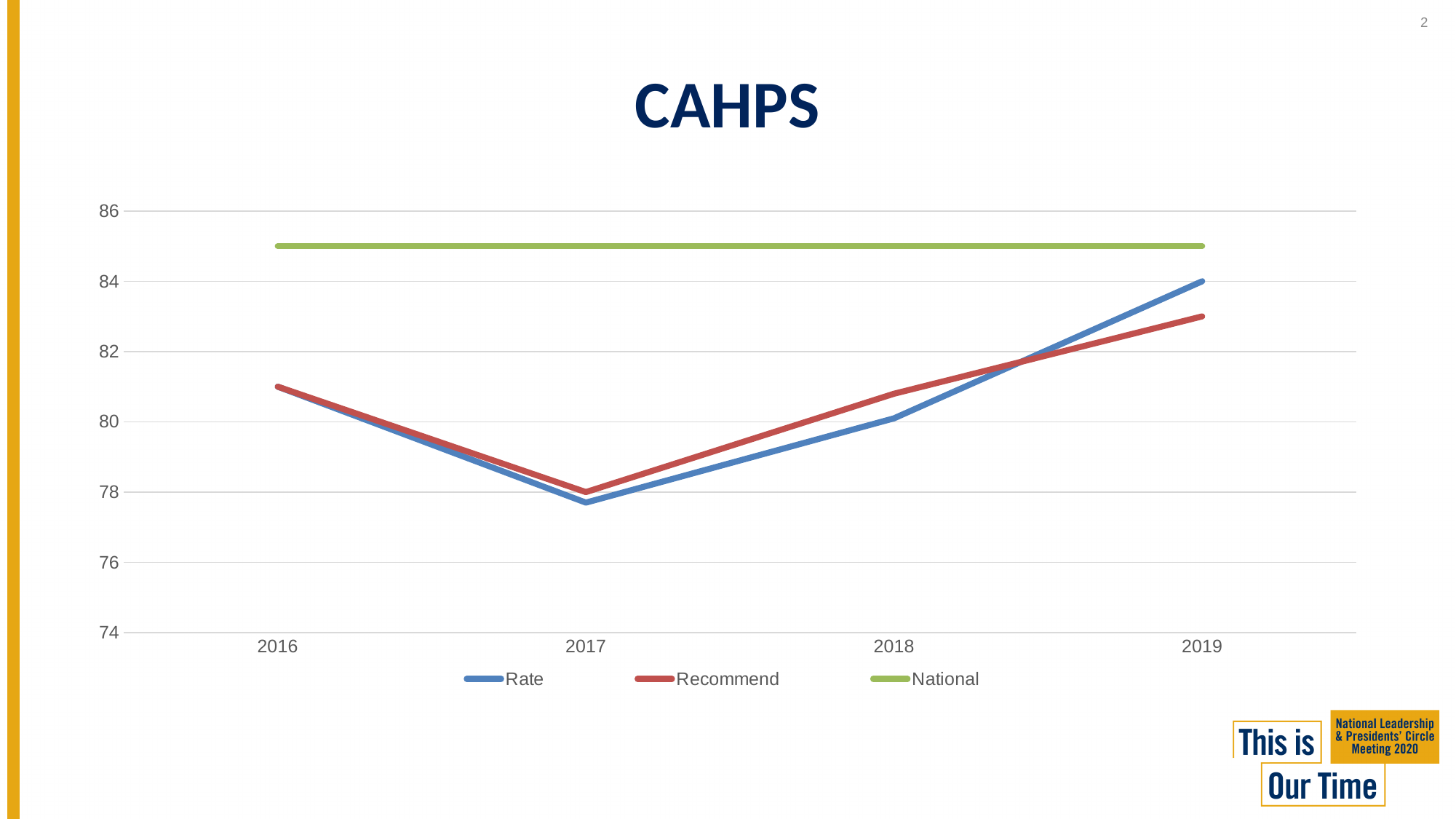
In which year is the Rate series at its lowest? 2017 What is the value of the Rate series in 2019? 84 In 2019, which is higher, Rate or Recommend? Rate Does the Rate series rise or fall from 2017 to 2019? rise How many series does the legend list? 3 What is the title of the chart? CAHPS What is the value of the Recommend series in 2017? 78 Is the value of the National series greater or less than 84? greater What kind of chart is shown on the slide? line chart Is the value of the Rate series in 2017 greater or less than 78? less Is the value of the Recommend series in 2019 greater or less than 82? greater How many years are shown on the x axis? 4